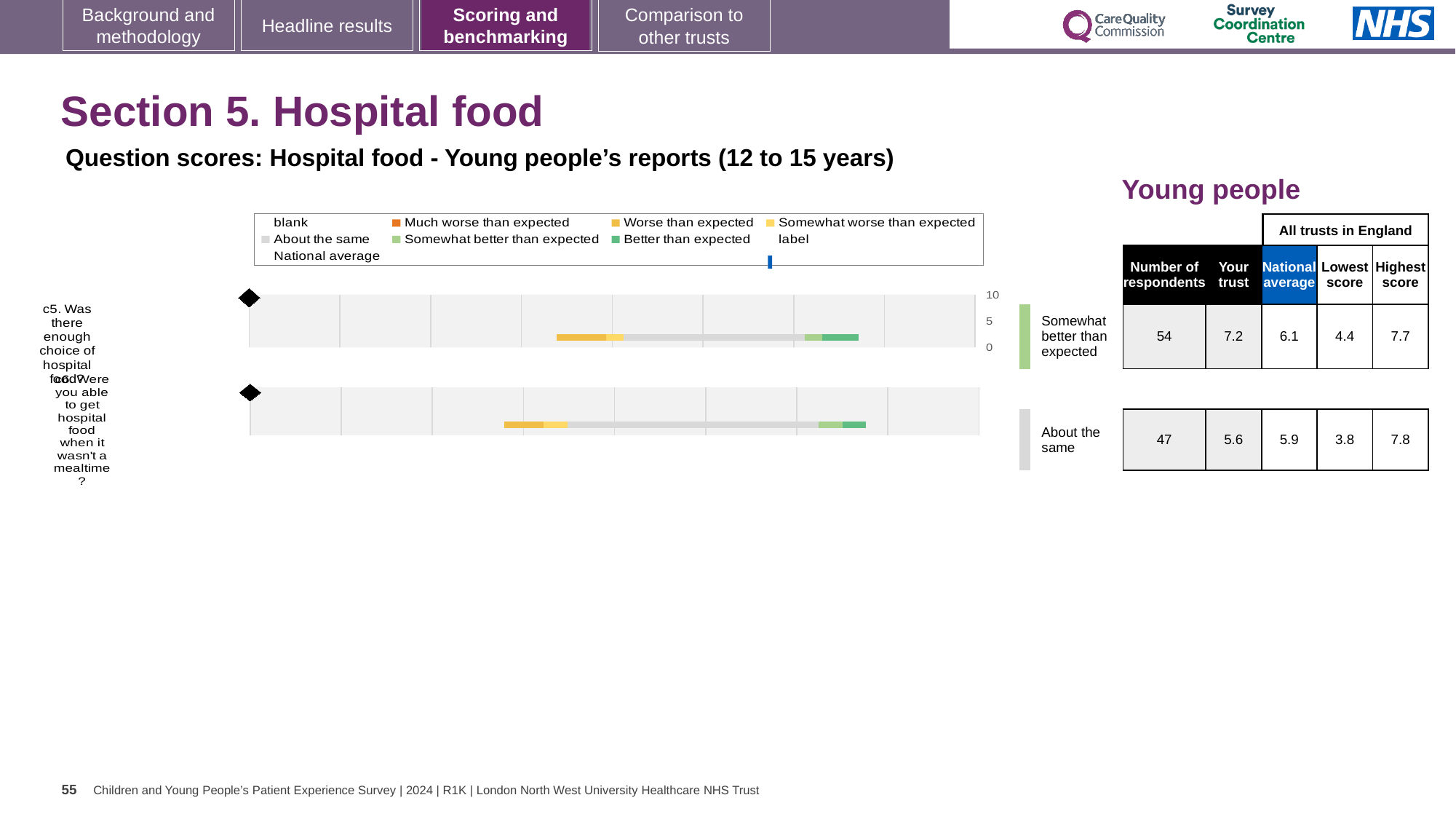
In the table beside the chart, what is the number of respondents for the first row? 54 How many survey questions (bars) are plotted in the chart? 2 Which survey question is the first (top) bar in the chart about? c5. Was there enough choice of hospital food? What is the highest tick value shown on the chart's axis? 10 What kind of chart is shown on the slide? bar chart In the table beside the chart, what is the 'Your trust' score for the first row (Somewhat better than expected)? 7.2 In the table beside the chart, what is the 'Your trust' score for the second row (About the same)? 5.6 How many entries does the chart legend list? 9 In the table beside the chart, which row has the higher 'Your trust' score, the first row or the second row? the first row In the table beside the chart, what is the 'Highest score' in the second row? 7.8 In the table beside the chart, what is the difference between the 'Your trust' score and the 'National average' in the first row? 1.1 What colour represents 'Better than expected' in the chart legend? green